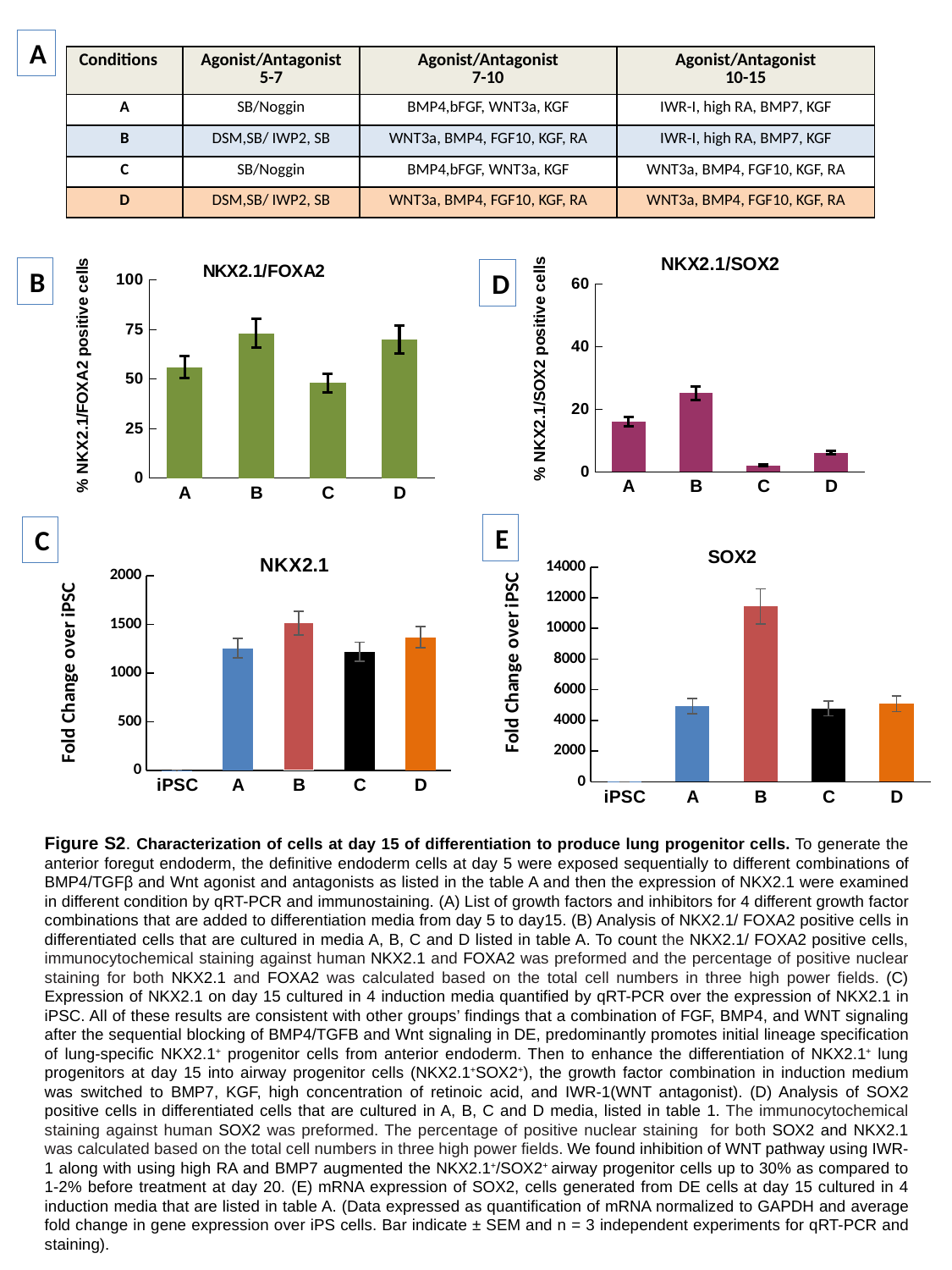
In the SOX2 fold change chart, is the value for condition B greater or less than 10000? greater In the NKX2.1/FOXA2 chart, which condition has the lowest percentage of positive cells? C In the NKX2.1/FOXA2 chart, is the value for condition B greater or less than 50? greater In the NKX2.1/FOXA2 chart, which is larger, the value for condition A or condition C? A How many categories are shown on the x axis of the SOX2 fold change chart? 5 In the NKX2.1/SOX2 chart, is the value for condition B greater or less than 20? greater In the NKX2.1/SOX2 chart, which condition has the lowest percentage of positive cells? C In the NKX2.1 fold change chart, which category has the highest value? B In the SOX2 fold change chart, which category has the highest value? B In the NKX2.1/SOX2 chart, which condition has the highest percentage of positive cells? B